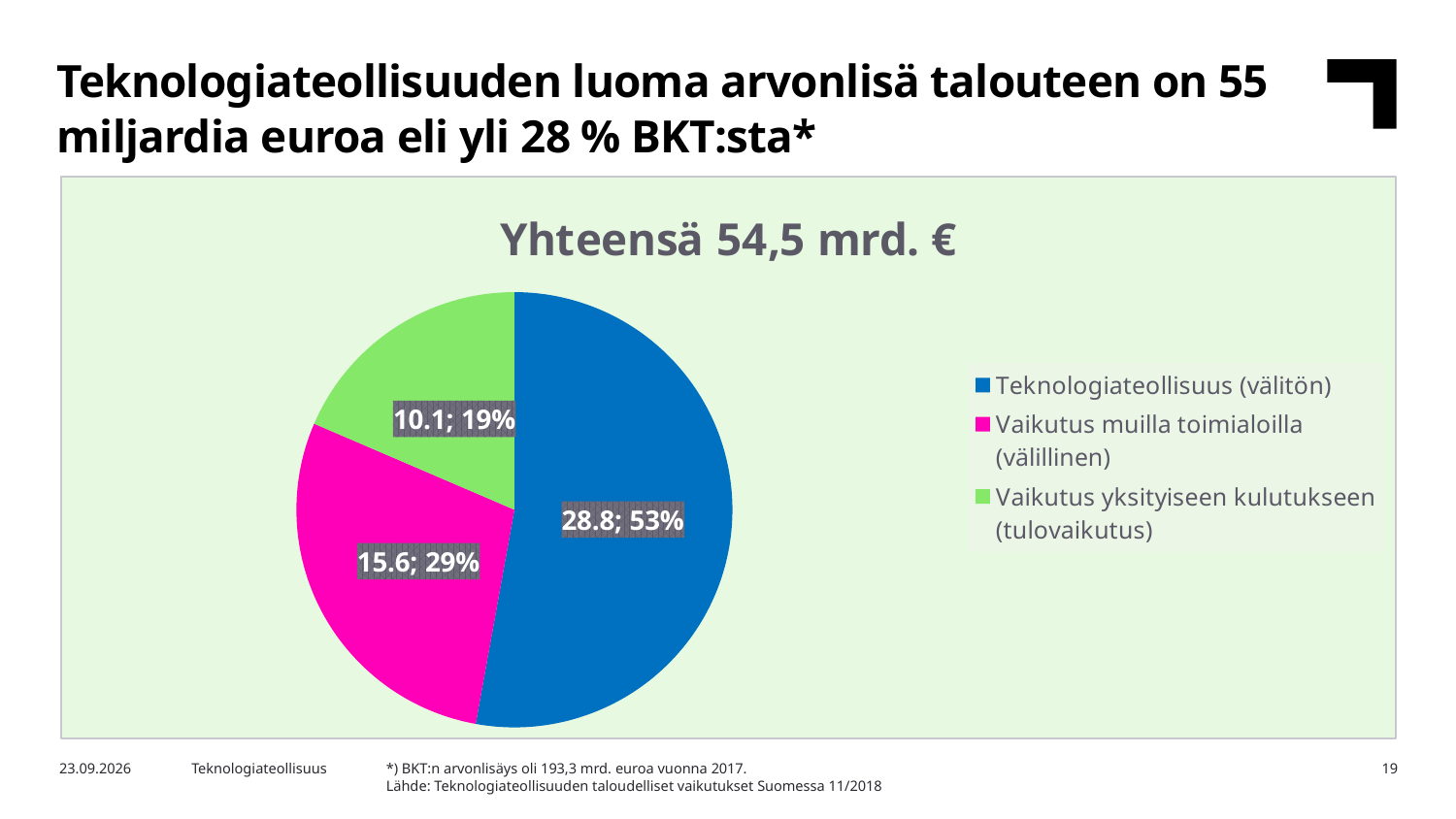
What is the title of the chart? Yhteensä 54,5 mrd. € What value is shown for Teknologiateollisuus (välitön)? 28.8 What kind of chart is shown on the slide? pie chart Which slice is the largest? Teknologiateollisuus (välitön) Which slice is the smallest? Vaikutus yksityiseen kulutukseen (tulovaikutus) What value is shown for Vaikutus muilla toimialoilla (välillinen)? 15.6 What is the difference between the values for Teknologiateollisuus (välitön) and Vaikutus muilla toimialoilla (välillinen)? 13.2 How many slices does the pie chart have? 3 How many entries does the legend list? 3 What value is shown for Vaikutus yksityiseen kulutukseen (tulovaikutus)? 10.1 What share of the pie does Teknologiateollisuus (välitön) represent? 53% What share of the pie does Vaikutus yksityiseen kulutukseen (tulovaikutus) represent? 19%